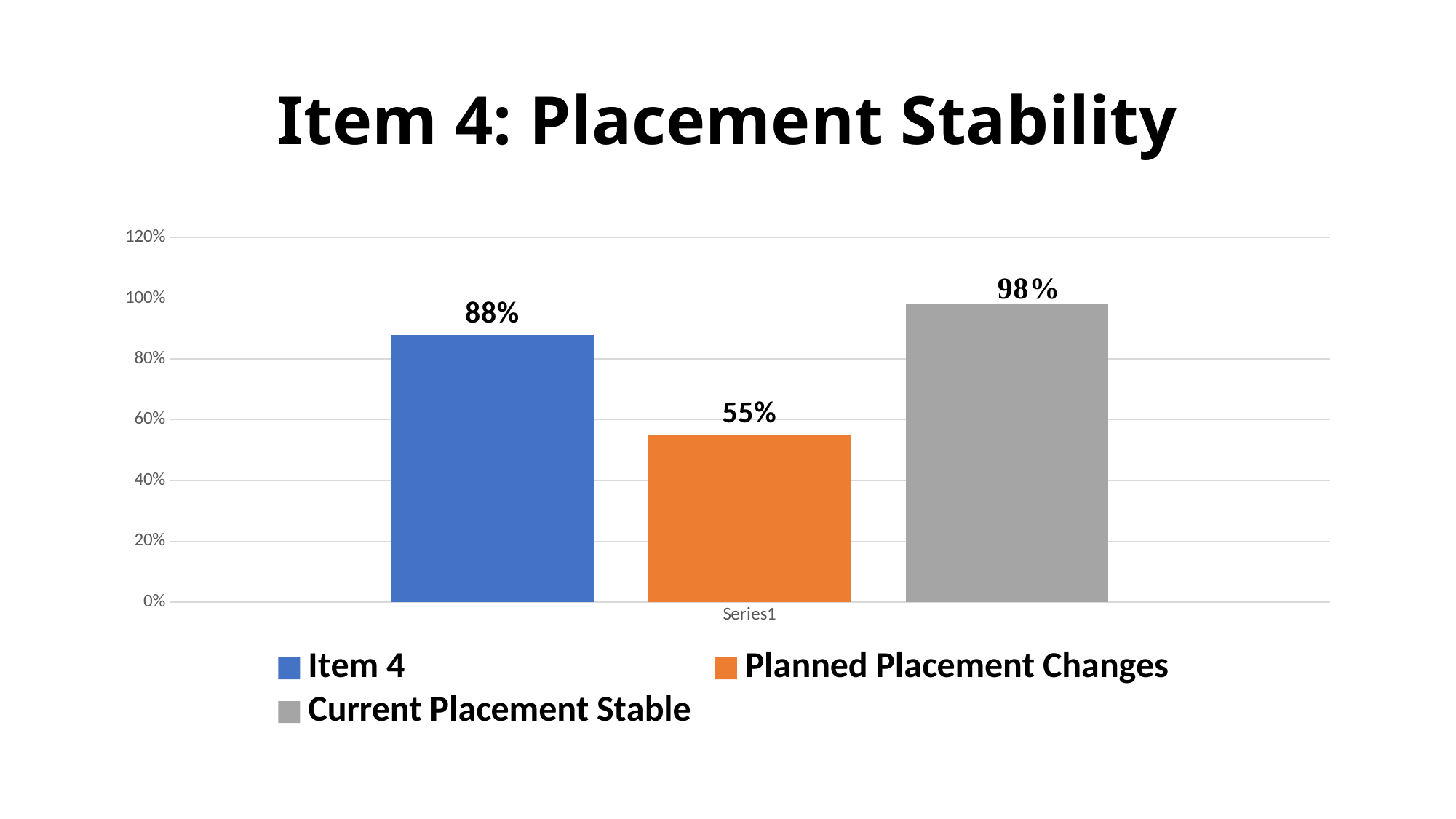
What kind of chart is shown on the slide? bar chart What is the title of the slide? Item 4: Placement Stability Which is larger, Item 4 or Planned Placement Changes? Item 4 Which series has the highest value? Current Placement Stable What is the value for Planned Placement Changes? 55% What is the value for Current Placement Stable? 98% Which series has the lowest value? Planned Placement Changes Is the value for Planned Placement Changes greater or less than 60%? less What is the difference between Current Placement Stable and Item 4? 10% What is the difference between Current Placement Stable and Planned Placement Changes? 43% How many series does the legend list? 3 What is the value for Item 4? 88%